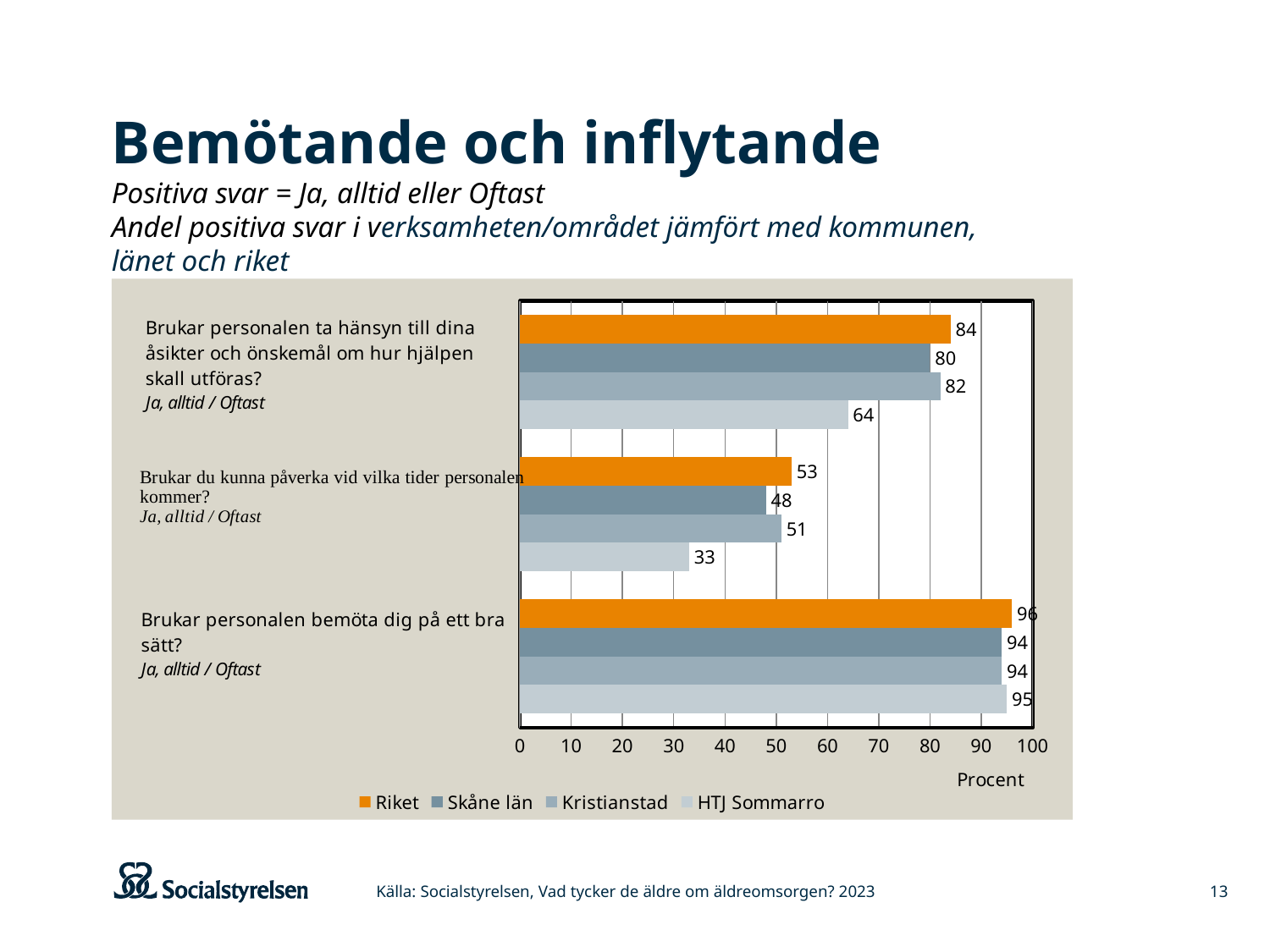
Which series has the lowest value for the question "Brukar du kunna påverka vid vilka tider personalen kommer?"? HTJ Sommarro What is the value for Riket for the question "Brukar du kunna påverka vid vilka tider personalen kommer?"? 53 How many series does the legend list? 4 Is the value for HTJ Sommarro for the question "Brukar du kunna påverka vid vilka tider personalen kommer?" greater or less than 40? less What is the difference between Riket and HTJ Sommarro for the question "Brukar du kunna påverka vid vilka tider personalen kommer?"? 20 Which series has the highest value for the question "Brukar personalen ta hänsyn till dina åsikter och önskemål om hur hjälpen skall utföras?"? Riket What is the value for HTJ Sommarro for the question "Brukar personalen ta hänsyn till dina åsikter och önskemål om hur hjälpen skall utföras?"? 64 Which is larger for the question "Brukar personalen ta hänsyn till dina åsikter och önskemål om hur hjälpen skall utföras?": Skåne län or Kristianstad? Kristianstad How many question categories are plotted in the chart? 3 What kind of chart is shown on the slide? bar chart What is the label on the x axis of the chart? Procent What is the value for Kristianstad for the question "Brukar personalen bemöta dig på ett bra sätt?"? 94